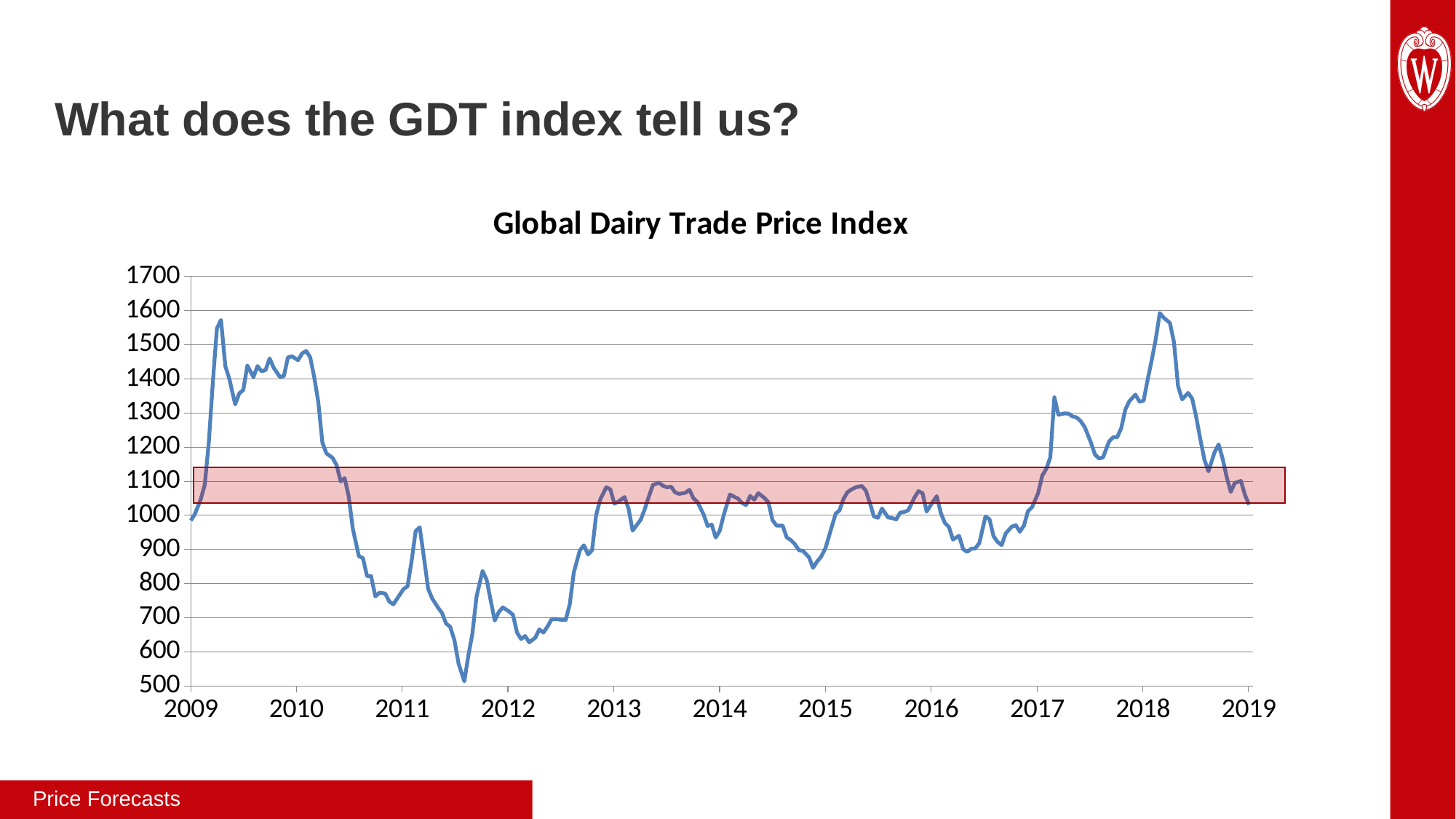
Which is larger, the index value at the start of 2010 or at the start of 2012? start of 2010 Is the value of the index at the start of 2012 greater or less than 900? less Does the index rise or fall between the start of 2017 and early 2018? rise Is the lowest value of the index in 2011 greater or less than 600? less What kind of chart is shown on the slide? line chart What is the title of the chart? Global Dairy Trade Price Index Is the value of the index at the start of 2010 greater or less than 1300? greater In which year does the index reach its lowest point? 2011 How many year labels are shown on the x axis? 11 Does the index rise or fall between the start of 2010 and mid-2011? fall